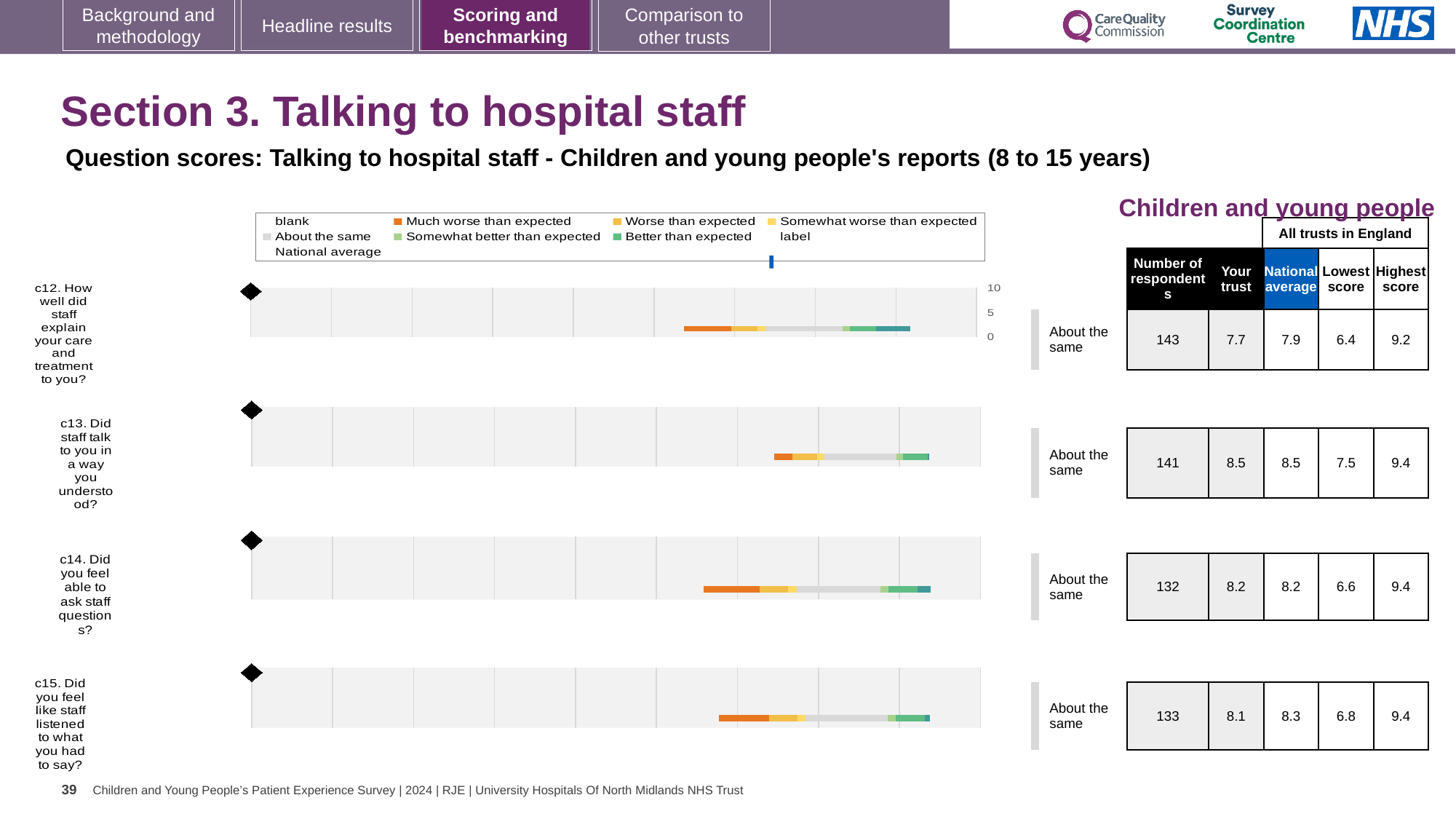
What is the lowest score among all trusts in England for question c13 (Did staff talk to you in a way you understood?)? 7.5 Which question has the lowest 'Your trust' score? c12. How well did staff explain your care and treatment to you? What benchmark category is shown for question c13 (Did staff talk to you in a way you understood?)? About the same How many entries does the chart legend list? 9 What kind of chart is used to show the question scores? Bar chart Which question has the highest 'Your trust' score? c13. Did staff talk to you in a way you understood? What is the 'Your trust' score for question c12 (How well did staff explain your care and treatment to you?)? 7.7 What is the national average score for question c15 (Did you feel like staff listened to what you had to say?)? 8.3 How many respondents answered question c14 (Did you feel able to ask staff questions?)? 132 How many questions are charted on the slide? 4 For question c12, what is the difference between the highest score and the lowest score among all trusts in England? 2.8 For question c15, which is larger: the 'Your trust' score or the national average? National average